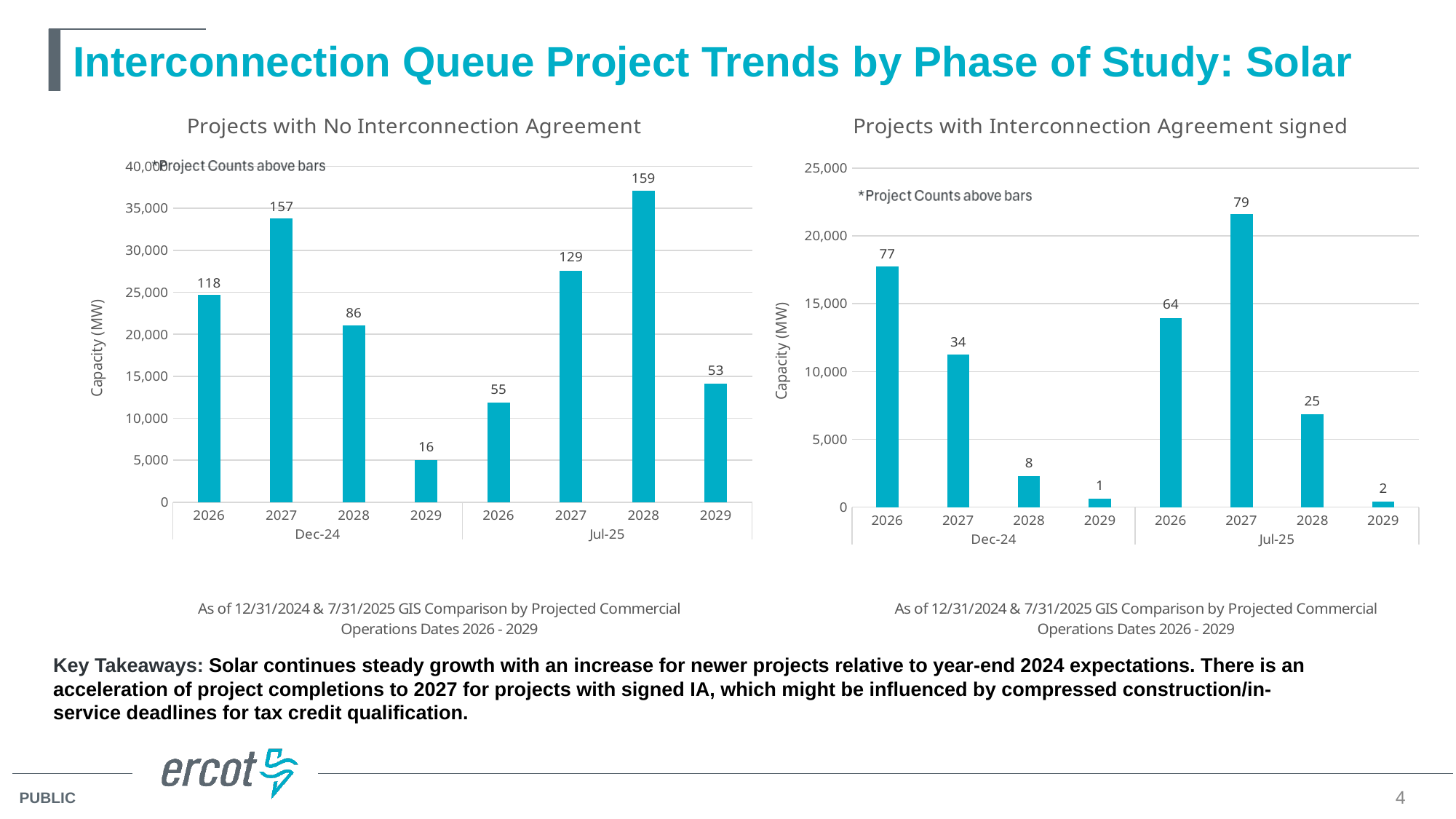
In the 'Projects with Interconnection Agreement signed' chart, is the capacity for 2027 in the Dec-24 group greater or less than 15,000 MW? less In the 'Projects with No Interconnection Agreement' chart, is the capacity for 2026 in the Dec-24 group greater or less than 20,000 MW? greater In the 'Projects with No Interconnection Agreement' chart, what is the difference between the project counts for 2028 in Jul-25 and 2028 in Dec-24? 73 In the 'Projects with Interconnection Agreement signed' chart, what is the project count shown above the 2029 bar in the Dec-24 group? 1 In the 'Projects with Interconnection Agreement signed' chart, what is the project count shown above the 2027 bar in the Jul-25 group? 79 In the 'Projects with No Interconnection Agreement' chart, what is the project count shown above the 2027 bar in the Dec-24 group? 157 What type of chart is the 'Projects with No Interconnection Agreement' chart? Bar chart In the 'Projects with Interconnection Agreement signed' chart, which bar has the lowest capacity? 2029 in Jul-25 In the 'Projects with Interconnection Agreement signed' chart, which has the larger capacity: 2026 in Dec-24 or 2026 in Jul-25? 2026 in Dec-24 In the 'Projects with No Interconnection Agreement' chart, which bar has the highest capacity? 2028 in Jul-25 In the 'Projects with No Interconnection Agreement' chart, what is the project count shown above the 2028 bar in the Jul-25 group? 159 How many bars are plotted in the 'Projects with Interconnection Agreement signed' chart? 8